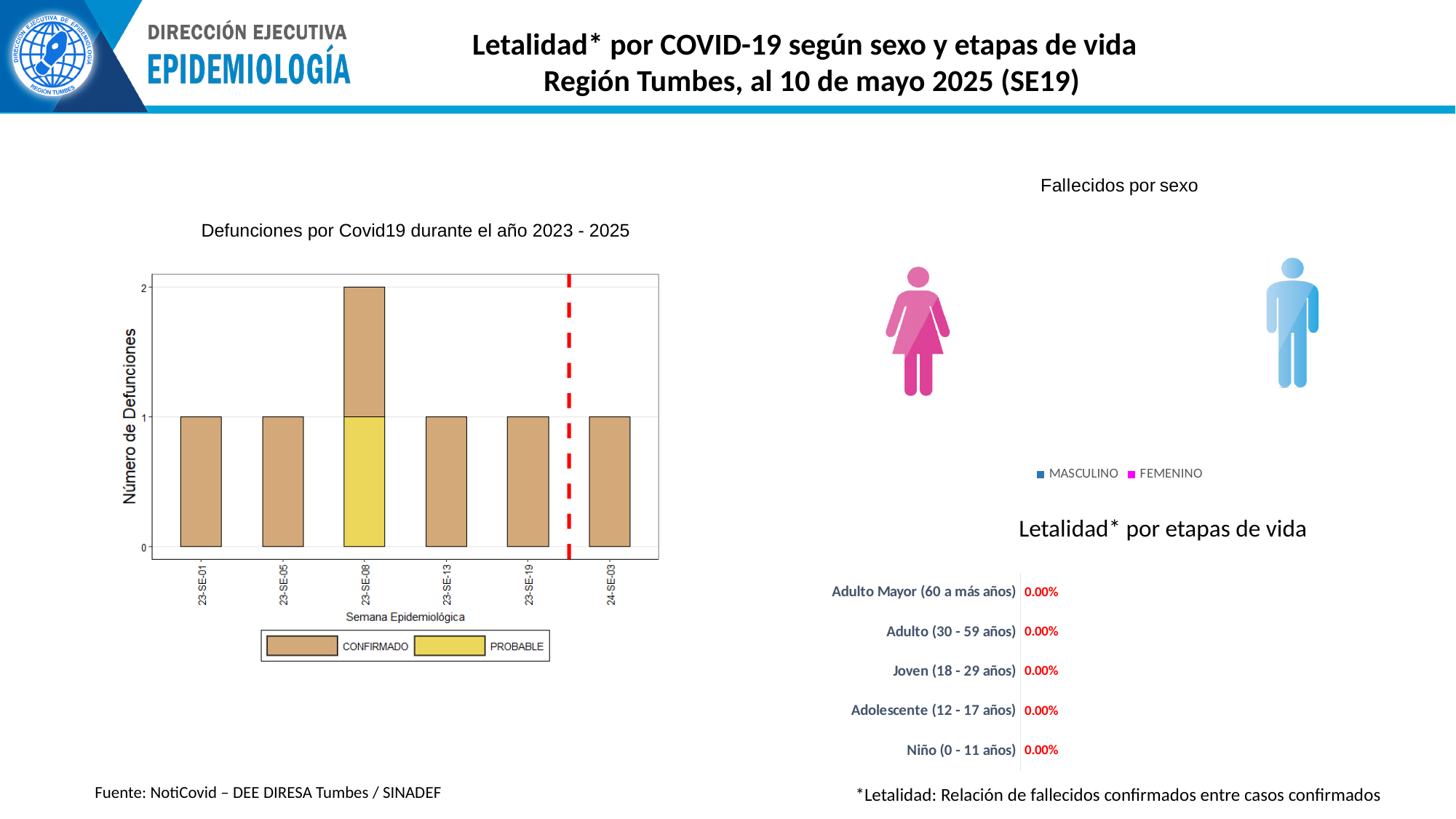
In the chart titled "Defunciones por Covid19 durante el año 2023 - 2025", what is the title of the x axis? Semana Epidemiológica In the chart titled "Defunciones por Covid19 durante el año 2023 - 2025", how many epidemiological weeks are shown on the x axis? 6 In the chart titled "Defunciones por Covid19 durante el año 2023 - 2025", what is the number of deaths for 23-SE-01? 1 In the chart titled "Defunciones por Covid19 durante el año 2023 - 2025", what is the total height of the stacked bar for 23-SE-08? 2 In the chart titled "Letalidad* por etapas de vida", what is the value for Adulto Mayor (60 a más años)? 0.00% In the chart titled "Defunciones por Covid19 durante el año 2023 - 2025", which week has more deaths, 23-SE-08 or 23-SE-13? 23-SE-08 In the chart titled "Defunciones por Covid19 durante el año 2023 - 2025", what kind of chart is shown? bar chart In the chart titled "Defunciones por Covid19 durante el año 2023 - 2025", how many series does the legend list? 2 In the chart titled "Defunciones por Covid19 durante el año 2023 - 2025", which week has the highest total number of deaths? 23-SE-08 In the chart titled "Defunciones por Covid19 durante el año 2023 - 2025", what is the difference between the total deaths in 23-SE-08 and in 23-SE-05? 1 In the chart titled "Letalidad* por etapas de vida", how many life-stage categories are listed? 5 In the chart titled "Defunciones por Covid19 durante el año 2023 - 2025", how many PROBABLE deaths are shown for 23-SE-08? 1